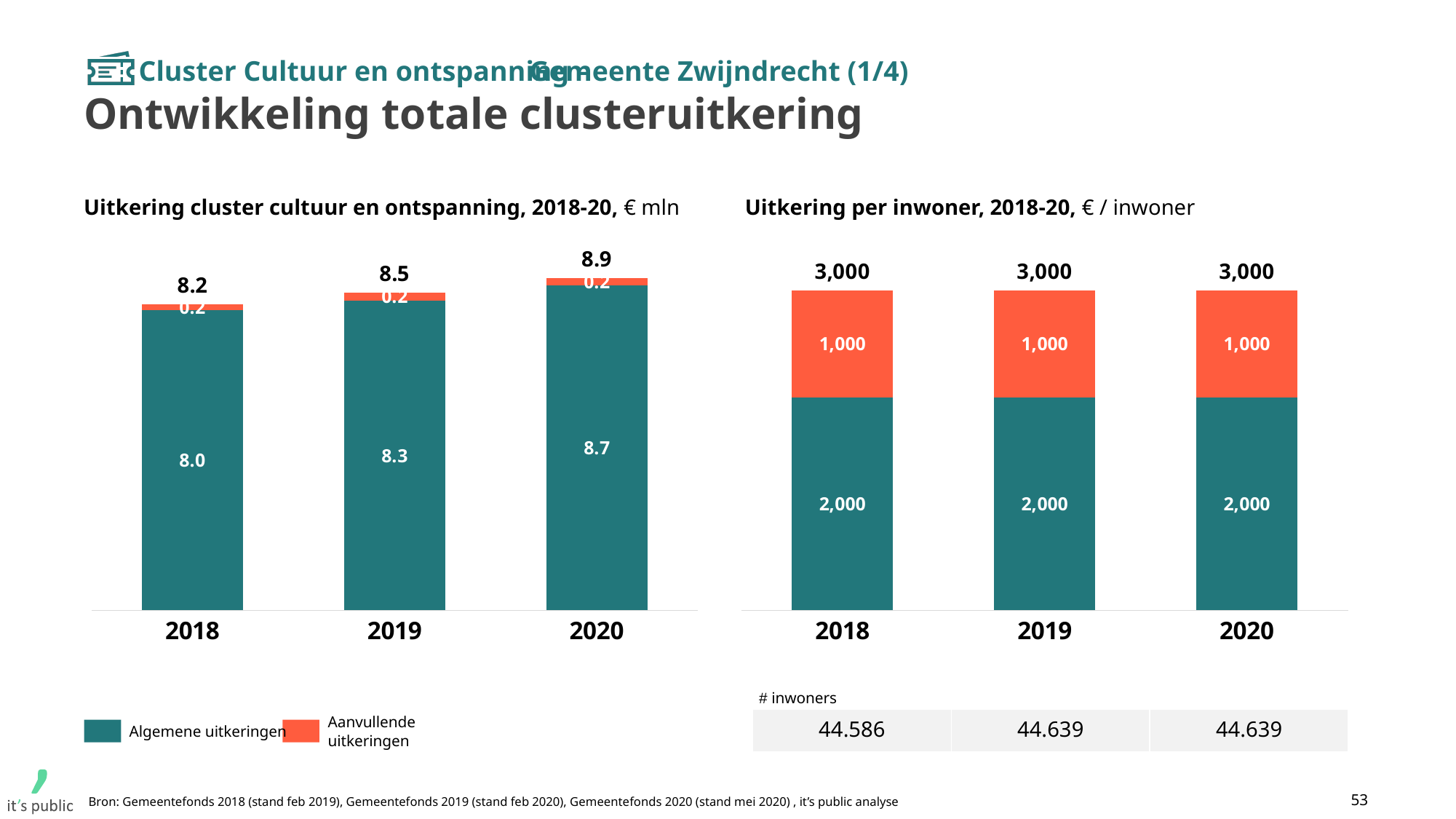
How many years are shown on the x axis of the chart 'Uitkering per inwoner, 2018-20'? 3 In the chart 'Uitkering per inwoner, 2018-20', what is the total of the stacked bar for 2019? 3,000 What kind of chart is 'Uitkering cluster cultuur en ontspanning, 2018-20'? stacked bar chart In the chart 'Uitkering per inwoner, 2018-20', what is the value of Aanvullende uitkeringen for 2018? 1,000 In the chart 'Uitkering per inwoner, 2018-20', what is the value of Algemene uitkeringen for 2020? 2,000 How many series does the legend on the slide list? 2 In the chart 'Uitkering cluster cultuur en ontspanning, 2018-20', what is the total of the stacked bar for 2020? 8.9 In the chart 'Uitkering cluster cultuur en ontspanning, 2018-20', what is the value of Algemene uitkeringen for 2019? 8.3 In the chart 'Uitkering cluster cultuur en ontspanning, 2018-20', what is the value of Aanvullende uitkeringen for 2018? 0.2 In the chart 'Uitkering cluster cultuur en ontspanning, 2018-20', do the total values rise or fall from 2018 to 2020? rise In the chart 'Uitkering cluster cultuur en ontspanning, 2018-20', which year has the highest total? 2020 In the chart 'Uitkering cluster cultuur en ontspanning, 2018-20', what is the difference between the Algemene uitkeringen values for 2020 and 2018? 0.7